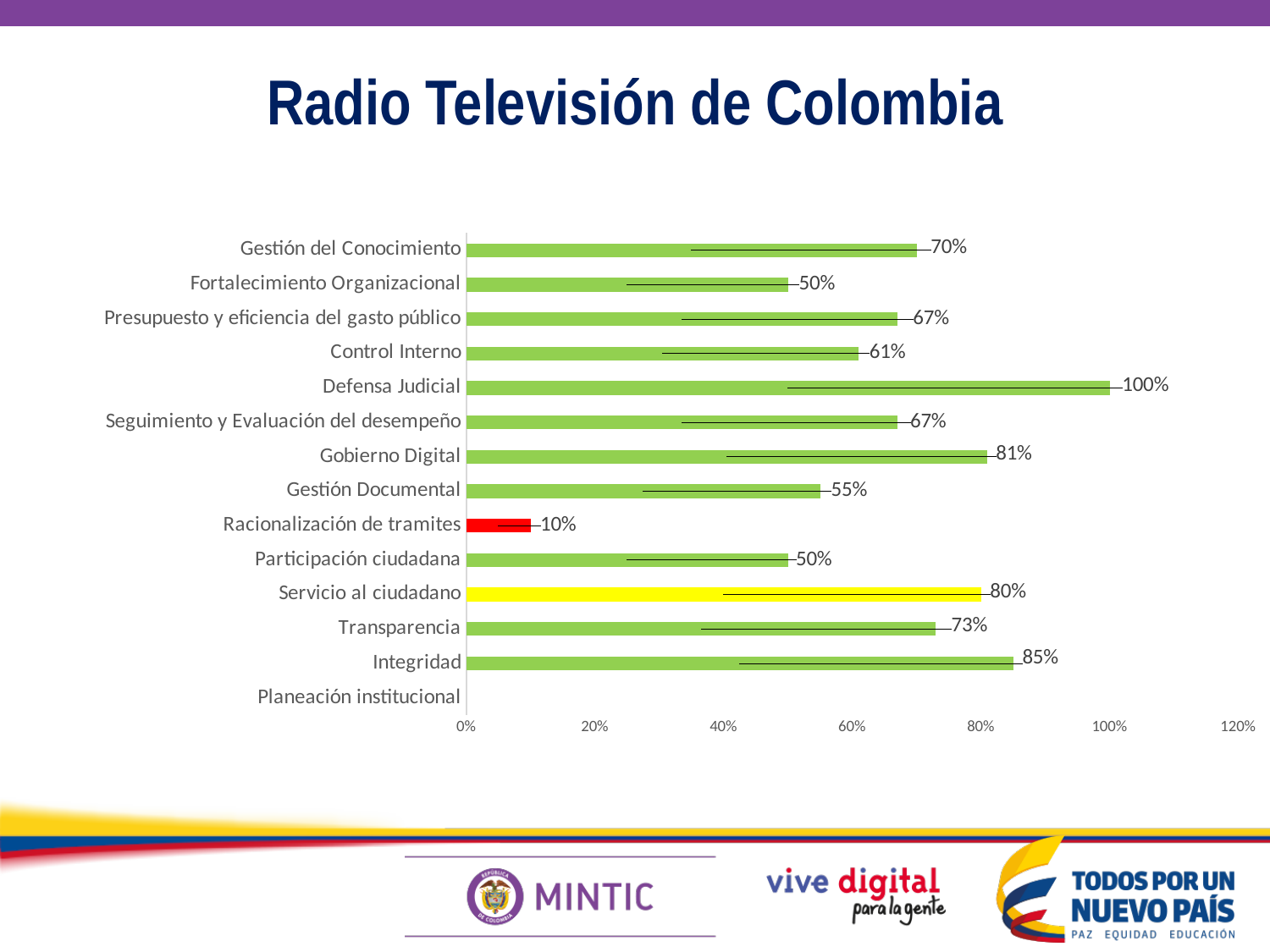
What is the value for Gobierno Digital? 81% What is the value for Defensa Judicial? 100% Which is larger, the value for Gestión del Conocimiento or the value for Control Interno? Gestión del Conocimiento Which category's bar is coloured red? Racionalización de tramites What is the value for Integridad? 85% What is the difference between the values for Integridad and Transparencia? 12% What is the title of the slide? Radio Televisión de Colombia What is the value for Racionalización de tramites? 10% Which category has the highest value? Defensa Judicial Which category has the lowest value shown with a bar? Racionalización de tramites How many categories are listed on the vertical axis? 14 What kind of chart is shown on the slide? Bar chart